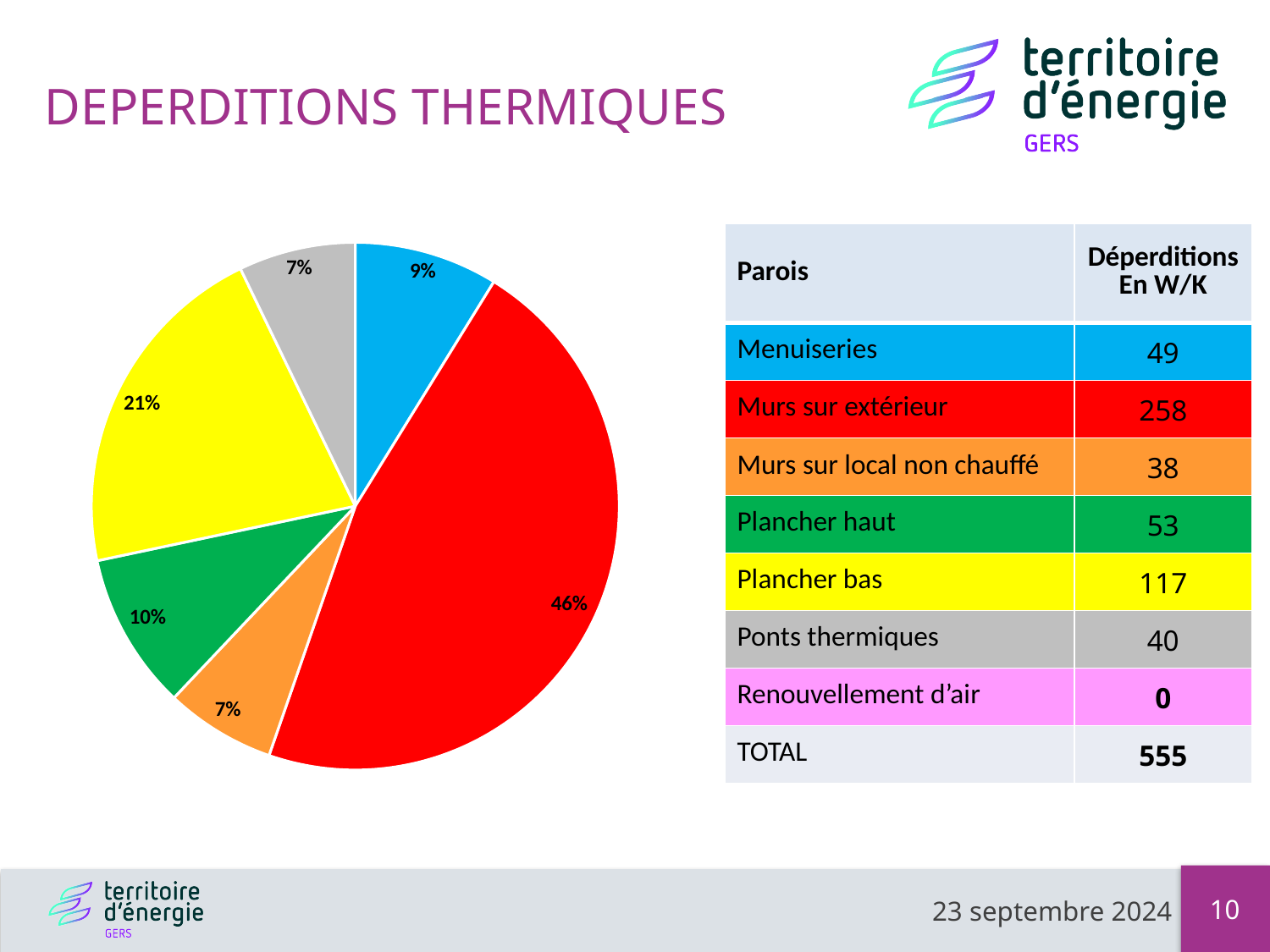
Which is larger in the pie chart: the yellow slice (Plancher bas) or the green slice (Plancher haut)? Plancher bas (yellow) What is the difference in percentage points between the red slice (46%) and the yellow slice (21%)? 25 percentage points What percentage is shown for the grey slice (Ponts thermiques)? 7% What is the title of the slide containing the pie chart? DEPERDITIONS THERMIQUES What share of the pie does the green slice (Plancher haut) represent? 10% What colour is the slice representing Murs sur local non chauffé (7%)? orange What share of the pie does the yellow slice (Plancher bas) represent? 21% How many slices are visible in the pie chart? 6 What kind of chart is shown on the slide? pie chart Which slice of the pie chart is the largest? Murs sur extérieur (red, 46%)